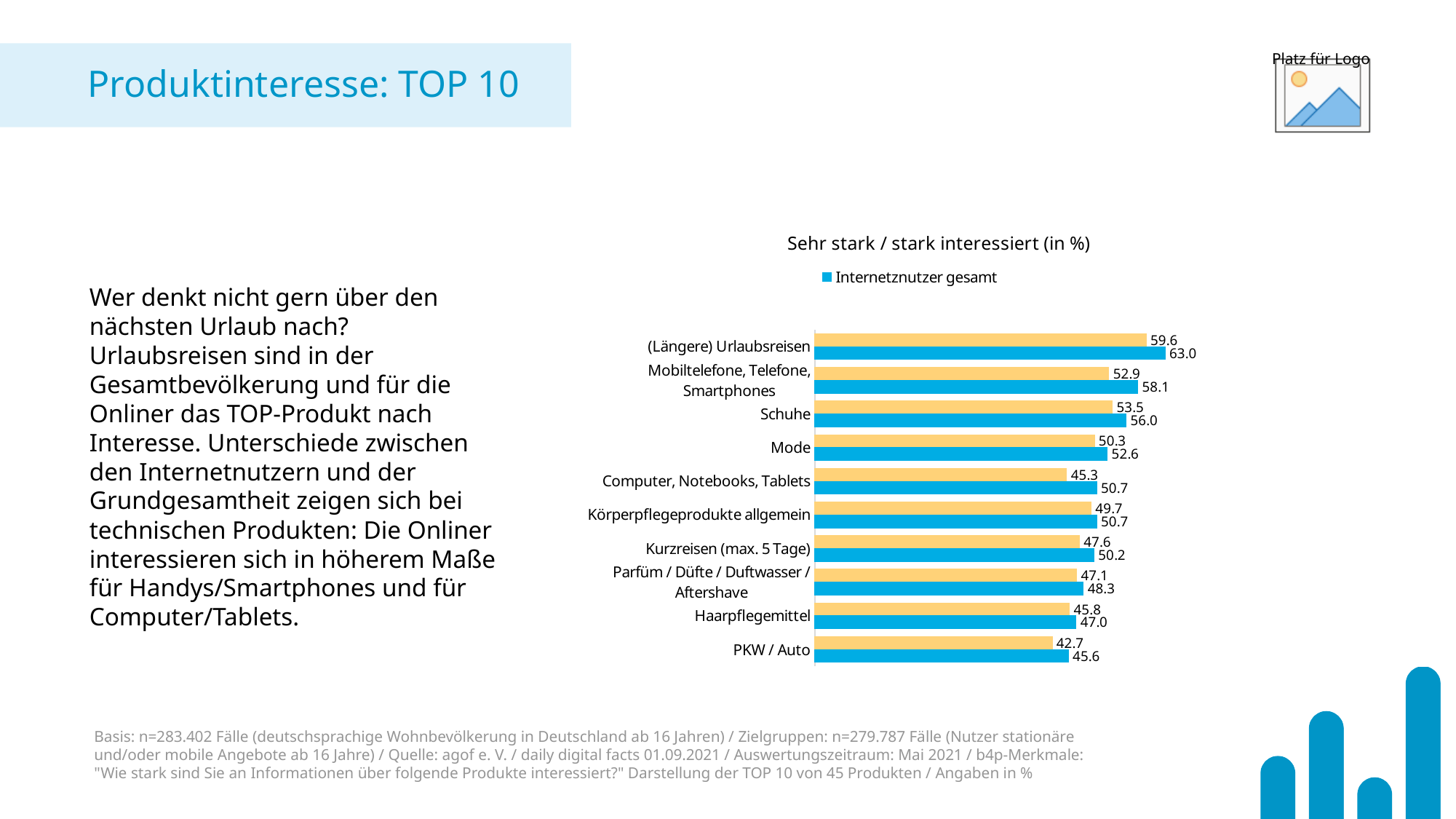
What is the value for Internetnutzer gesamt for Schuhe? 56.0 How many series does the chart legend list? 1 Which category has the lowest value for Internetnutzer gesamt? PKW / Auto What is the value for Internetnutzer gesamt for PKW / Auto? 45.6 What is the difference between the Internetnutzer gesamt values for (Längere) Urlaubsreisen and Mobiltelefone, Telefone, Smartphones? 4.9 What is the value for Internetnutzer gesamt for (Längere) Urlaubsreisen? 63.0 What is the title of the chart? Sehr stark / stark interessiert (in %) What type of chart is shown on the slide? bar chart What is the value for Internetnutzer gesamt for Haarpflegemittel? 47.0 How many product categories are shown in the chart? 10 For Internetnutzer gesamt, which is larger: Mode or Kurzreisen (max. 5 Tage)? Mode Which category has the highest value for Internetnutzer gesamt? (Längere) Urlaubsreisen